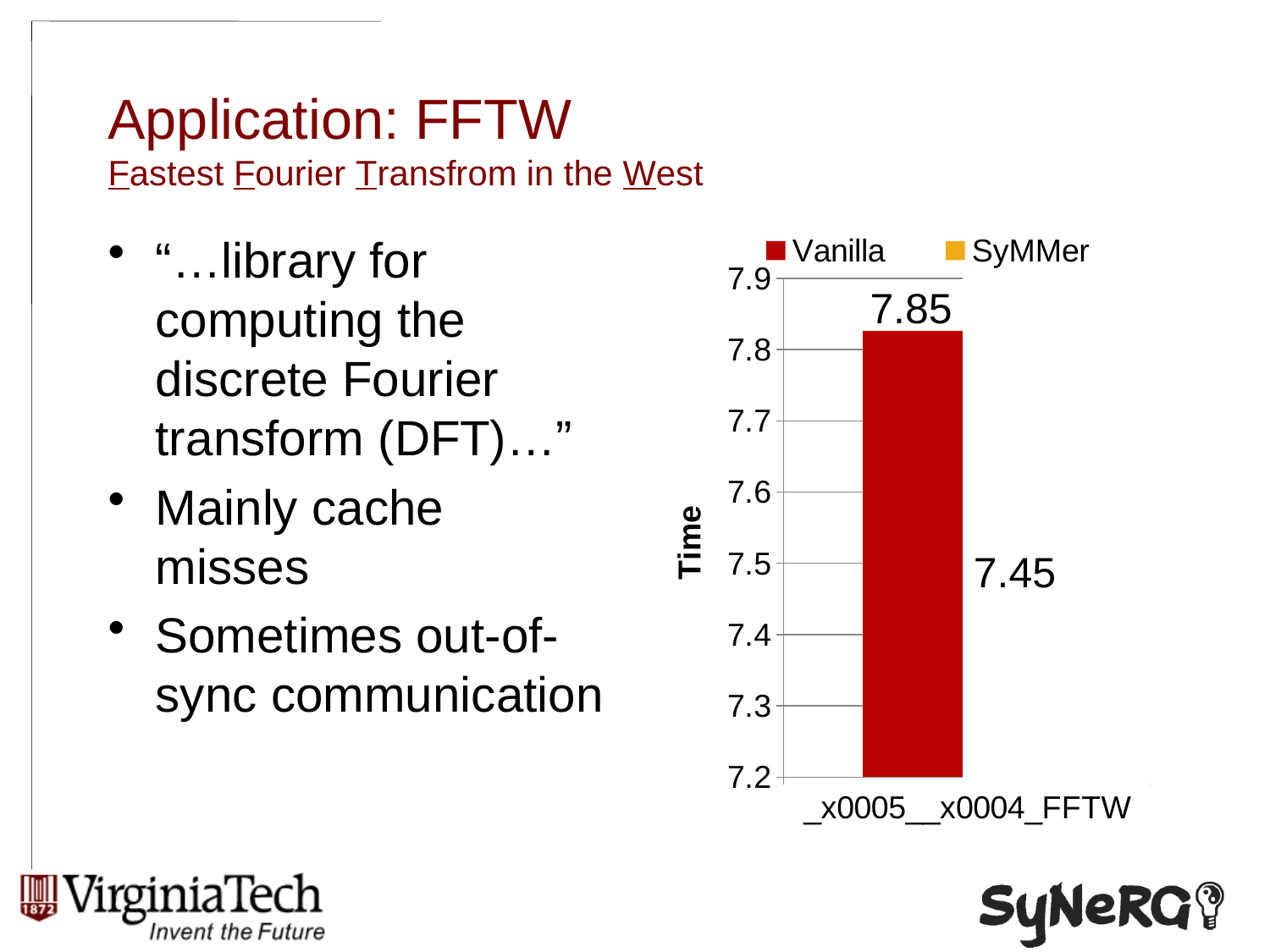
Is the SyMMer value greater or less than 7.5? less What is the title of the vertical axis? Time What is the SyMMer value shown on the chart? 7.45 How many series does the legend list? 2 What colour represents the Vanilla series in the legend? Red What kind of chart is shown on the slide? Bar chart Is the Vanilla value greater or less than 7.8? greater Which series has the lowest value on the chart? SyMMer How many categories are shown on the x axis of the chart? 1 Which series has the higher value, Vanilla or SyMMer? Vanilla What is the difference between the Vanilla and SyMMer values? 0.4 What is the Vanilla value shown on the chart? 7.85